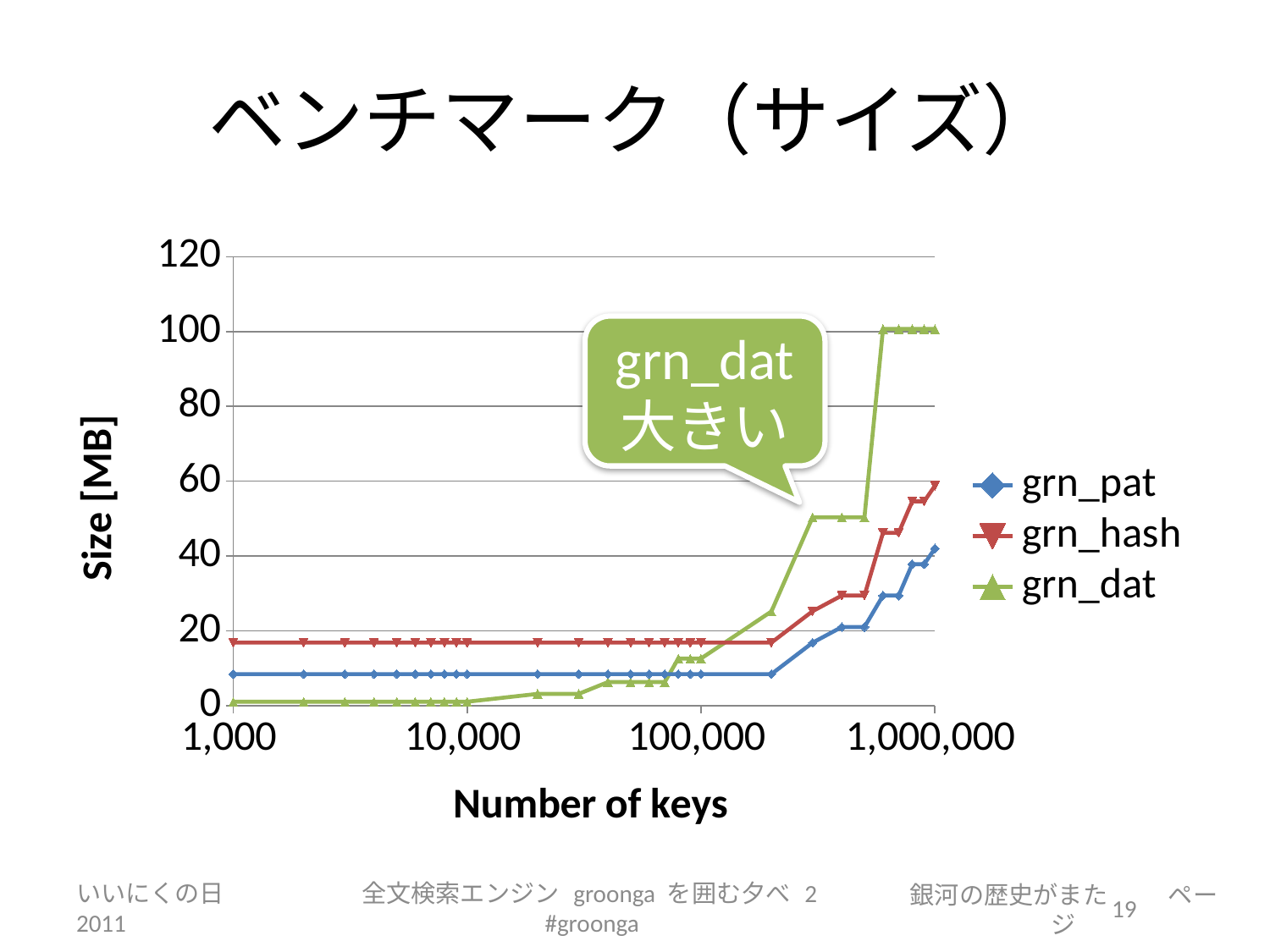
Which series has the smallest size at 1,000 keys? grn_dat Is the size for grn_hash at 1,000 keys greater or less than 20 MB? less Which series has the largest size at 10,000 keys? grn_hash Is the size for grn_pat at 1,000,000 keys greater or less than 60 MB? less At 1,000 keys, which is larger: grn_hash or grn_pat? grn_hash How many series does the legend list? 3 Which series has the largest size at 1,000,000 keys? grn_dat What is the title of the y axis? Size [MB] Does the size for grn_dat rise or fall as the number of keys increases? rise What kind of chart is shown on the slide? line chart Is the size for grn_hash at 1,000,000 keys greater or less than 40 MB? greater